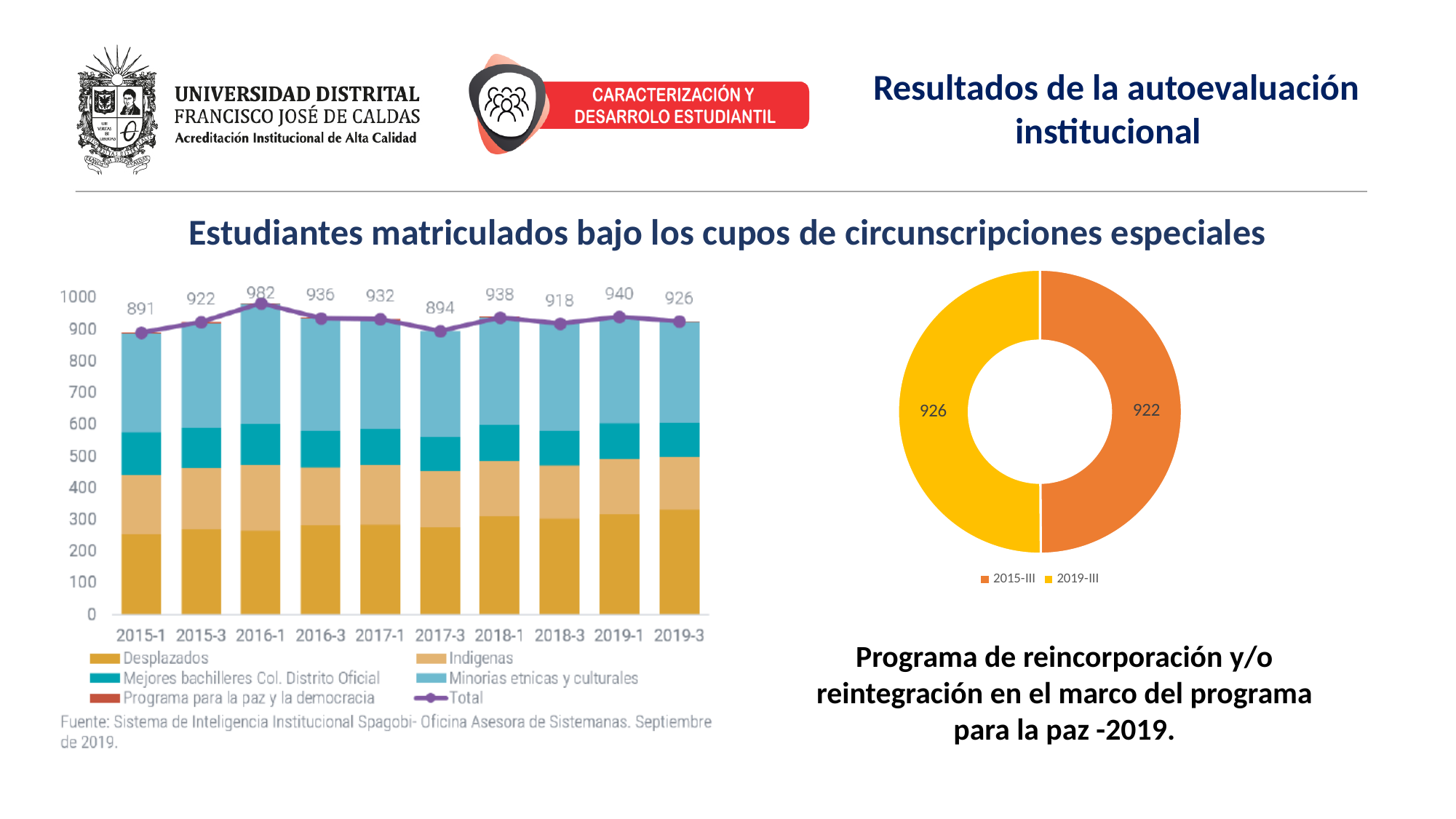
In the stacked bar chart on the left, which is larger, the Total for 2019-1 or the Total for 2019-3? 2019-1 In the stacked bar chart on the left, what is the difference between the Total for 2016-1 and the Total for 2017-3? 88 In the stacked bar chart on the left, how many periods are shown on the x axis? 10 In the stacked bar chart on the left, which period has the lowest Total? 2015-1 In the donut chart on the right, what is the value for 2019-III? 926 In the stacked bar chart on the left, how many entries does the legend list? 6 In the stacked bar chart on the left, what is the Total for 2015-1? 891 In the donut chart on the right, what is the difference between the 2019-III value and the 2015-III value? 4 In the stacked bar chart on the left, what is the Total for 2016-1? 982 In the stacked bar chart on the left, which period has the highest Total? 2016-1 In the stacked bar chart on the left, is the Desplazados value for 2019-3 greater or less than 300? greater What type of chart is shown on the right side of the slide? Donut (pie) chart